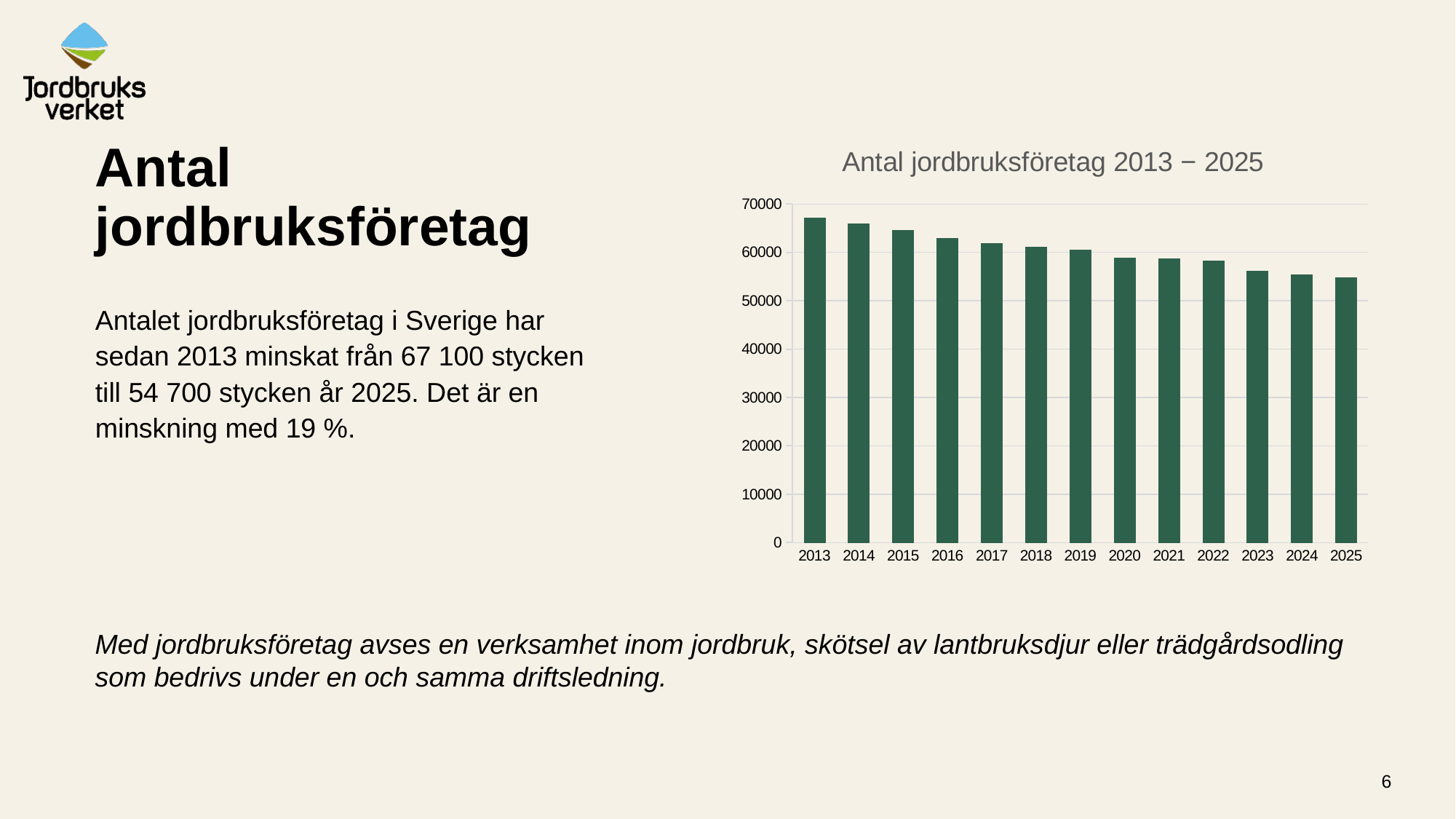
Which is larger, the value for 2024 or the value for 2017? 2017 Is the value for 2013 greater or less than 60000? greater How many years (bars) are shown in the chart? 13 What is the title of the chart? Antal jordbruksföretag 2013 − 2025 Is the value for 2020 greater or less than 50000? greater Which year has the highest number of jordbruksföretag? 2013 What kind of chart is shown on the slide? bar chart What colour are the bars in the chart? dark green Which year has the lowest number of jordbruksföretag? 2025 Which is larger, the value for 2015 or the value for 2023? 2015 Do the values rise or fall from 2013 to 2025? fall Is the value for 2025 greater or less than 60000? less